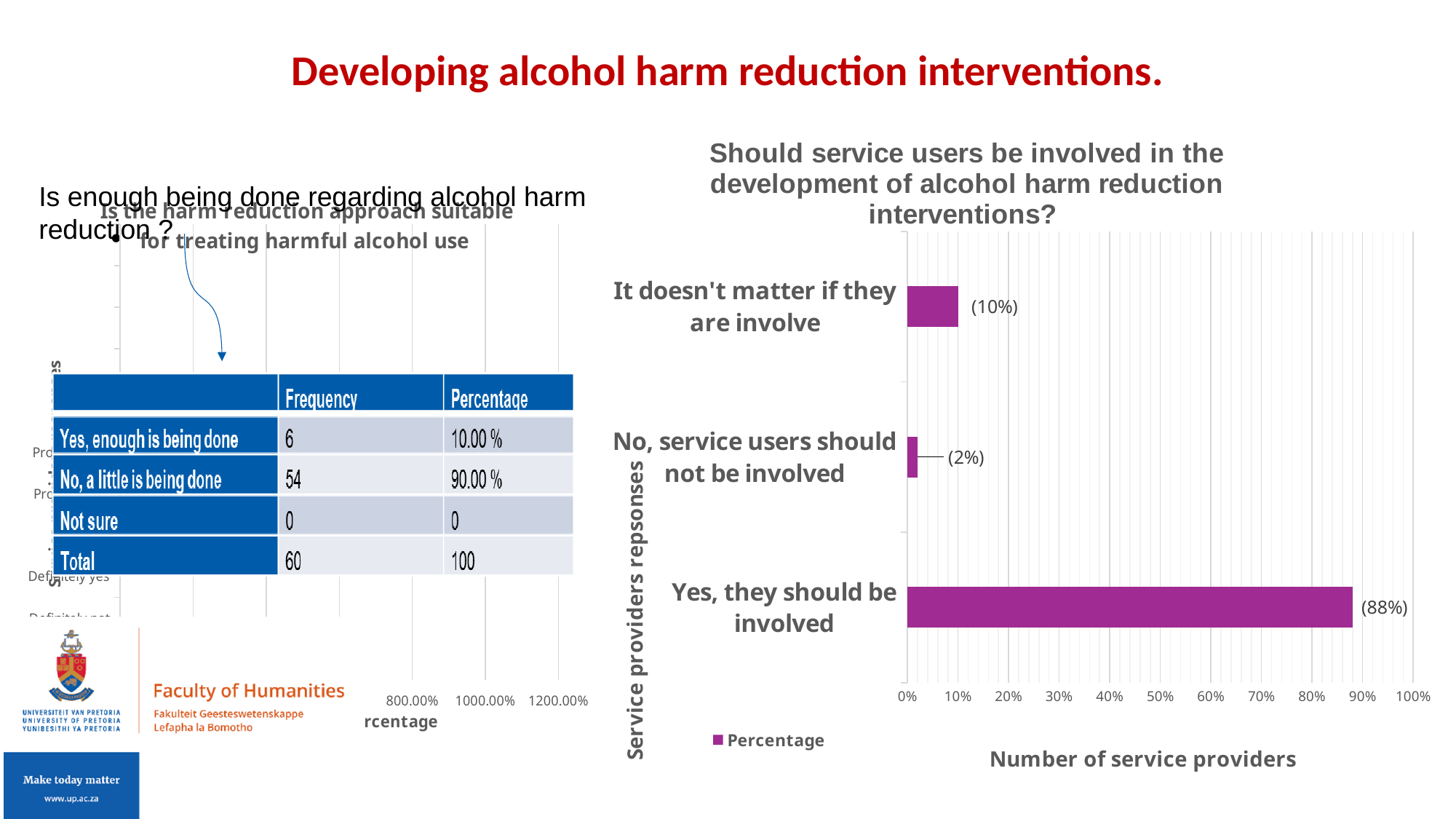
In the chart titled "Should service users be involved in the development of alcohol harm reduction interventions?", what is the title of the horizontal axis? Number of service providers In the chart titled "Should service users be involved in the development of alcohol harm reduction interventions?", what is the value for "It doesn't matter if they are involve"? (10%) In the chart titled "Should service users be involved in the development of alcohol harm reduction interventions?", how many series does the legend list? 1 In the chart titled "Should service users be involved in the development of alcohol harm reduction interventions?", what is the difference between the values for "Yes, they should be involved" and "It doesn't matter if they are involve"? 78% What kind of chart is the chart titled "Should service users be involved in the development of alcohol harm reduction interventions?"? bar chart In the chart titled "Should service users be involved in the development of alcohol harm reduction interventions?", how many response categories are shown? 3 In the chart titled "Should service users be involved in the development of alcohol harm reduction interventions?", what is the value for "Yes, they should be involved"? (88%) In the chart titled "Should service users be involved in the development of alcohol harm reduction interventions?", which response has the highest value? Yes, they should be involved In the chart titled "Should service users be involved in the development of alcohol harm reduction interventions?", what is the value for "No, service users should not be involved"? (2%) In the chart titled "Should service users be involved in the development of alcohol harm reduction interventions?", which is larger: the value for "It doesn't matter if they are involve" or for "No, service users should not be involved"? It doesn't matter if they are involve In the chart titled "Should service users be involved in the development of alcohol harm reduction interventions?", which response has the lowest value? No, service users should not be involved In the chart titled "Should service users be involved in the development of alcohol harm reduction interventions?", is the value for "Yes, they should be involved" greater or less than 80%? greater